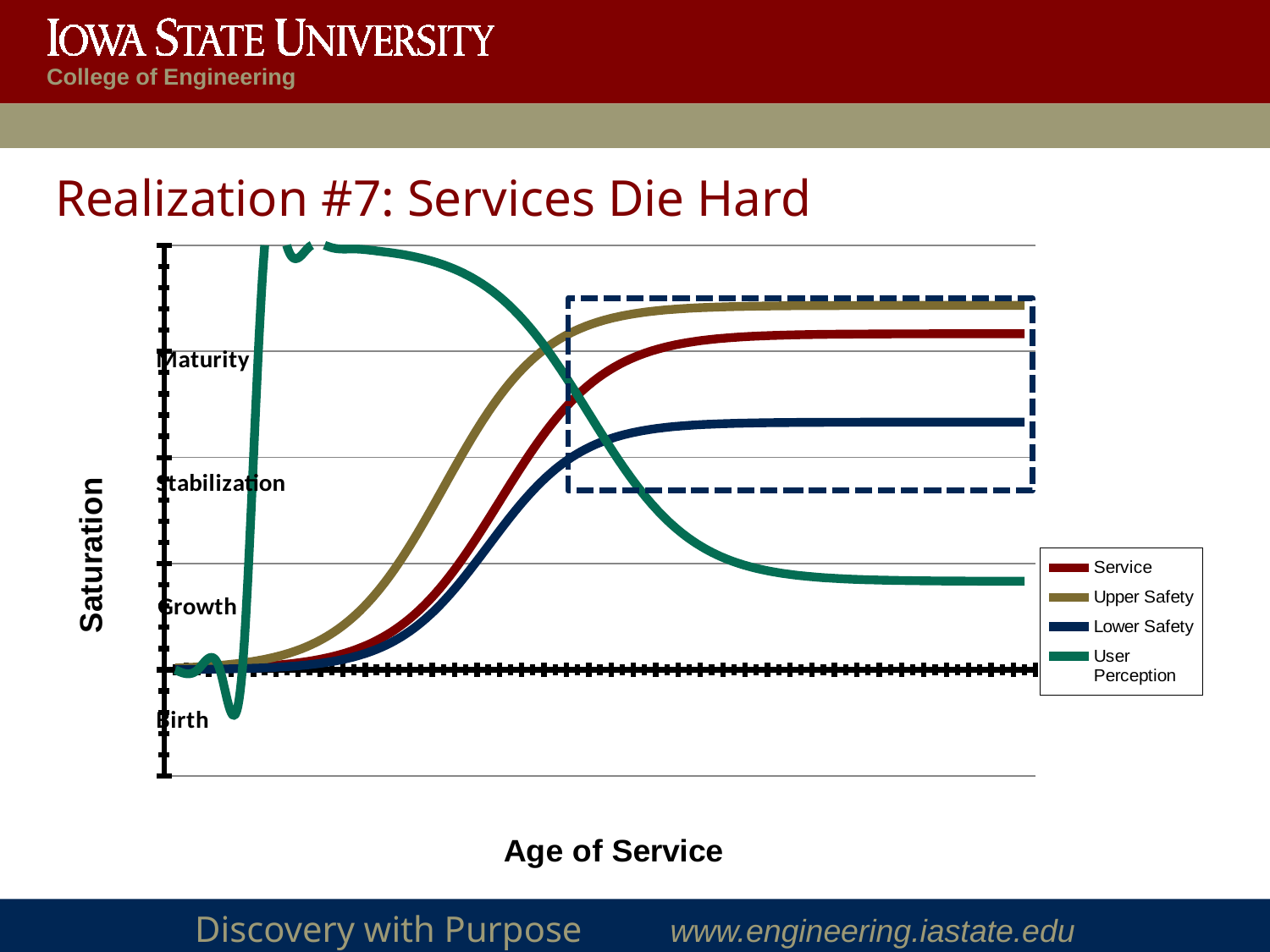
At the right end of the chart, is the Upper Safety line above or below the Service line? Above What is the title of the vertical axis? Saturation Does the Service line rise or fall as Age of Service increases? Rises What is the title of the horizontal axis? Age of Service Which stage label on the vertical axis is the highest? Maturity How many series does the legend list? 4 Does the User Perception line rise or fall over the right half of the chart? Falls At the right end of the chart, which series is highest: Upper Safety, Service, or Lower Safety? Upper Safety What kind of chart is shown on the slide? Line chart At the right end of the chart, which of the four series is lowest? User Perception At the right end of the chart, is the Service line above or below the Lower Safety line? Above